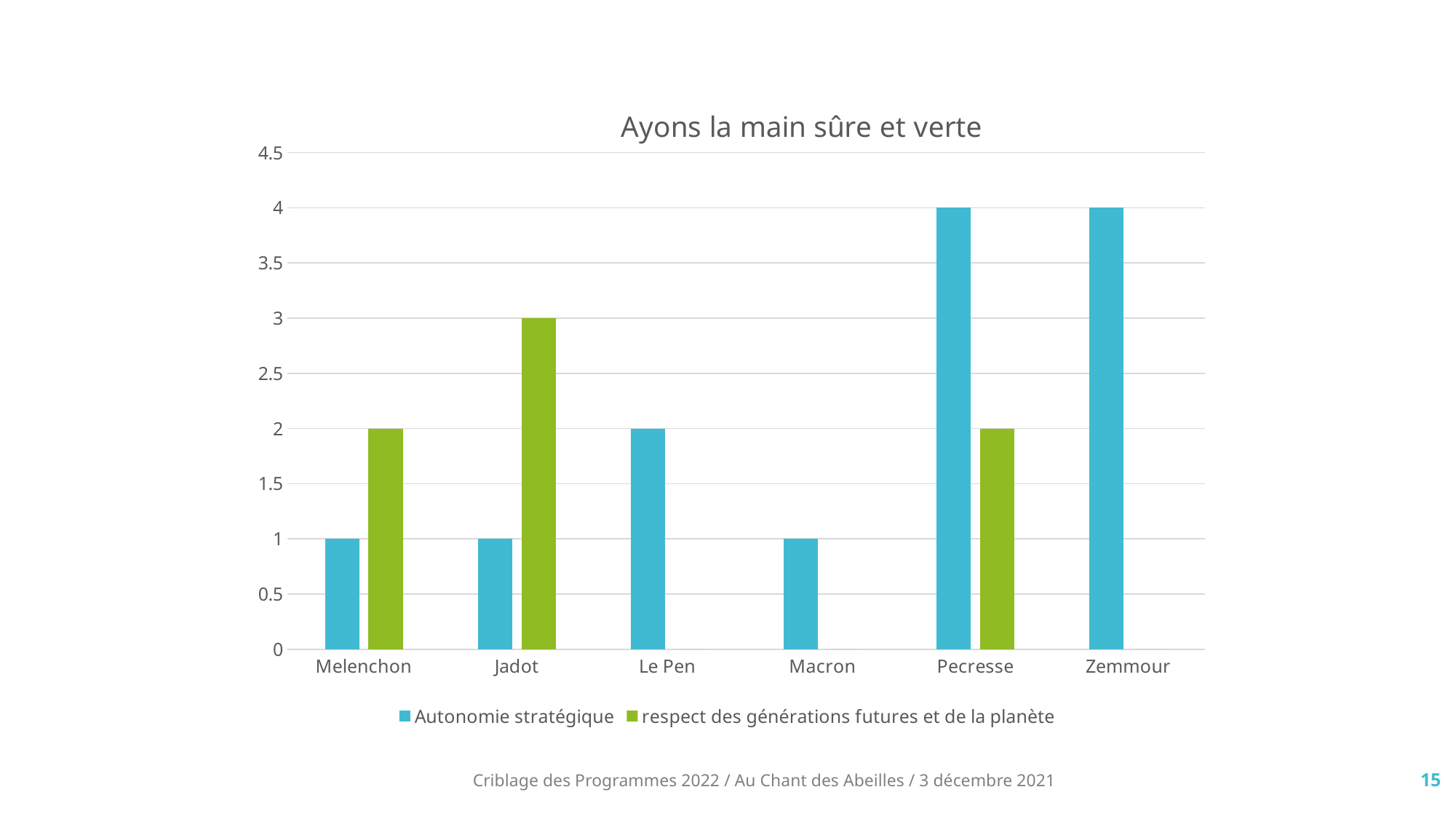
In the 'Autonomie stratégique' series, which is larger: Le Pen or Macron? Le Pen How many candidates (categories) are shown on the x axis? 6 Which candidate has the highest value in the 'respect des générations futures et de la planète' series? Jadot Is the 'Autonomie stratégique' value for Zemmour greater or less than 3? greater What is the value for Pecresse in the 'Autonomie stratégique' series? 4 What is the value for Le Pen in the 'Autonomie stratégique' series? 2 For Melenchon, which series has the larger value: 'Autonomie stratégique' or 'respect des générations futures et de la planète'? respect des générations futures et de la planète For Pecresse, what is the difference between the 'Autonomie stratégique' value and the 'respect des générations futures et de la planète' value? 2 What kind of chart is shown on the slide? bar chart How many series does the legend list? 2 What is the value for Jadot in the 'respect des générations futures et de la planète' series? 3 What is the title of the chart? Ayons la main sûre et verte